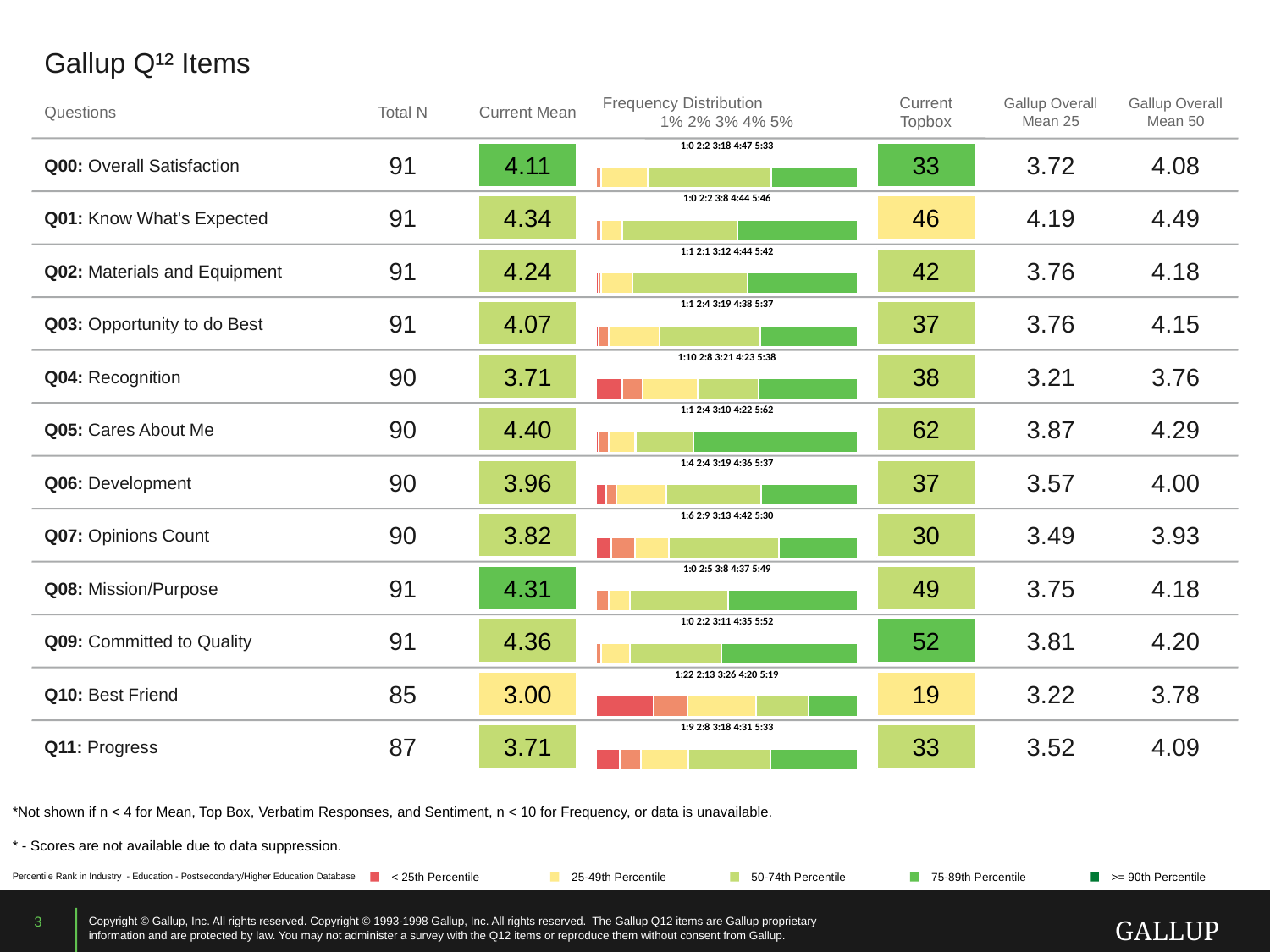
How many frequency distribution bars are shown on the slide? 12 In the frequency distribution bar for Q07: Opinions Count, what percentage of responses were a 2? 9% Across the frequency distribution bars, which question has the lowest percentage of 5 responses? Q10: Best Friend Across the frequency distribution bars, which question has the highest percentage of 5 responses? Q05: Cares About Me What kind of chart is used in the Frequency Distribution column? Stacked bar chart In the frequency distribution bar for Q10: Best Friend, what percentage of responses were a 1? 22% In the frequency distribution bar for Q00: Overall Satisfaction, what is the combined percentage of 4 and 5 responses? 80 In the frequency distribution bar for Q04: Recognition, which is larger, the percentage of 4 responses or the percentage of 5 responses? 5 responses In the frequency distribution bar for Q00: Overall Satisfaction, what percentage of responses were a 4? 47% What is the difference between the percentage of 5 responses for Q05: Cares About Me and for Q10: Best Friend? 43 How many segments (response levels) make up each frequency distribution bar? 5 What is the Current Mean shown for Q10: Best Friend? 3.00